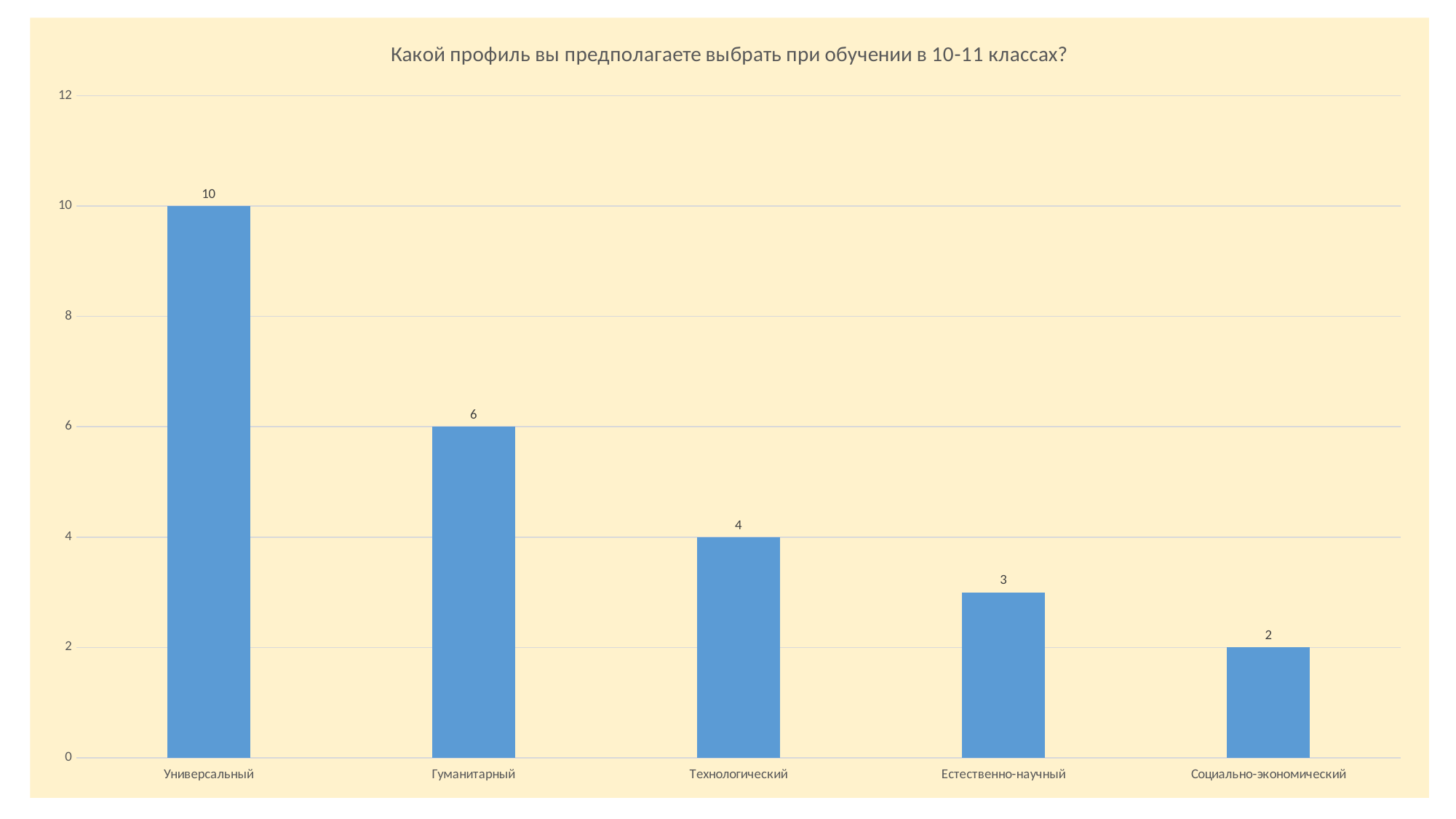
What is the value for Гуманитарный? 6 Which is larger, the value for Технологический or the value for Естественно-научный? Технологический What is the value for Социально-экономический? 2 Which category has the lowest value? Социально-экономический What is the title of the chart? Какой профиль вы предполагаете выбрать при обучении в 10-11 классах? What kind of chart is this? Bar chart What is the value for Универсальный? 10 Which category has the highest value? Универсальный How many categories are shown on the x axis? 5 What is the value for Технологический? 4 What is the difference between the values for Универсальный and Гуманитарный? 4 What is the value for Естественно-научный? 3